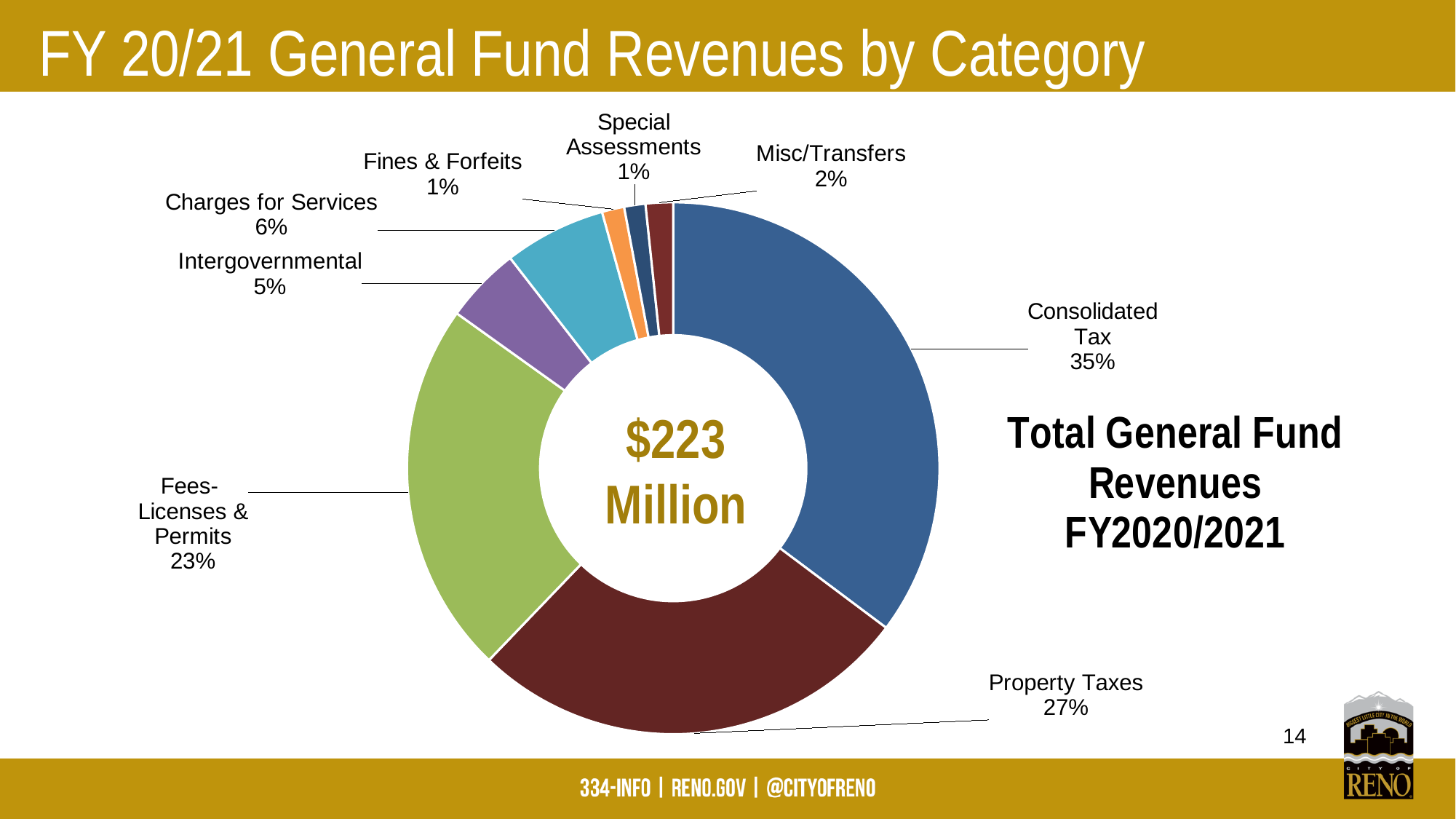
What kind of chart is used on this slide? Pie chart (donut) What total amount is shown in the center of the chart? $223 Million What percentage is shown for Charges for Services? 6% How many revenue categories are shown in the chart? 8 What percentage is shown for Intergovernmental revenues? 5% What share of FY 20/21 General Fund revenues comes from Consolidated Tax? 35% What share of revenues comes from Fees-Licenses & Permits? 23% Which category is larger, Property Taxes or Fees-Licenses & Permits? Property Taxes What is the difference in percentage points between Consolidated Tax and Property Taxes? 8 What percentage is shown for Misc/Transfers? 2% Which revenue category has the largest share of the General Fund? Consolidated Tax What percentage of General Fund revenues is from Property Taxes? 27%